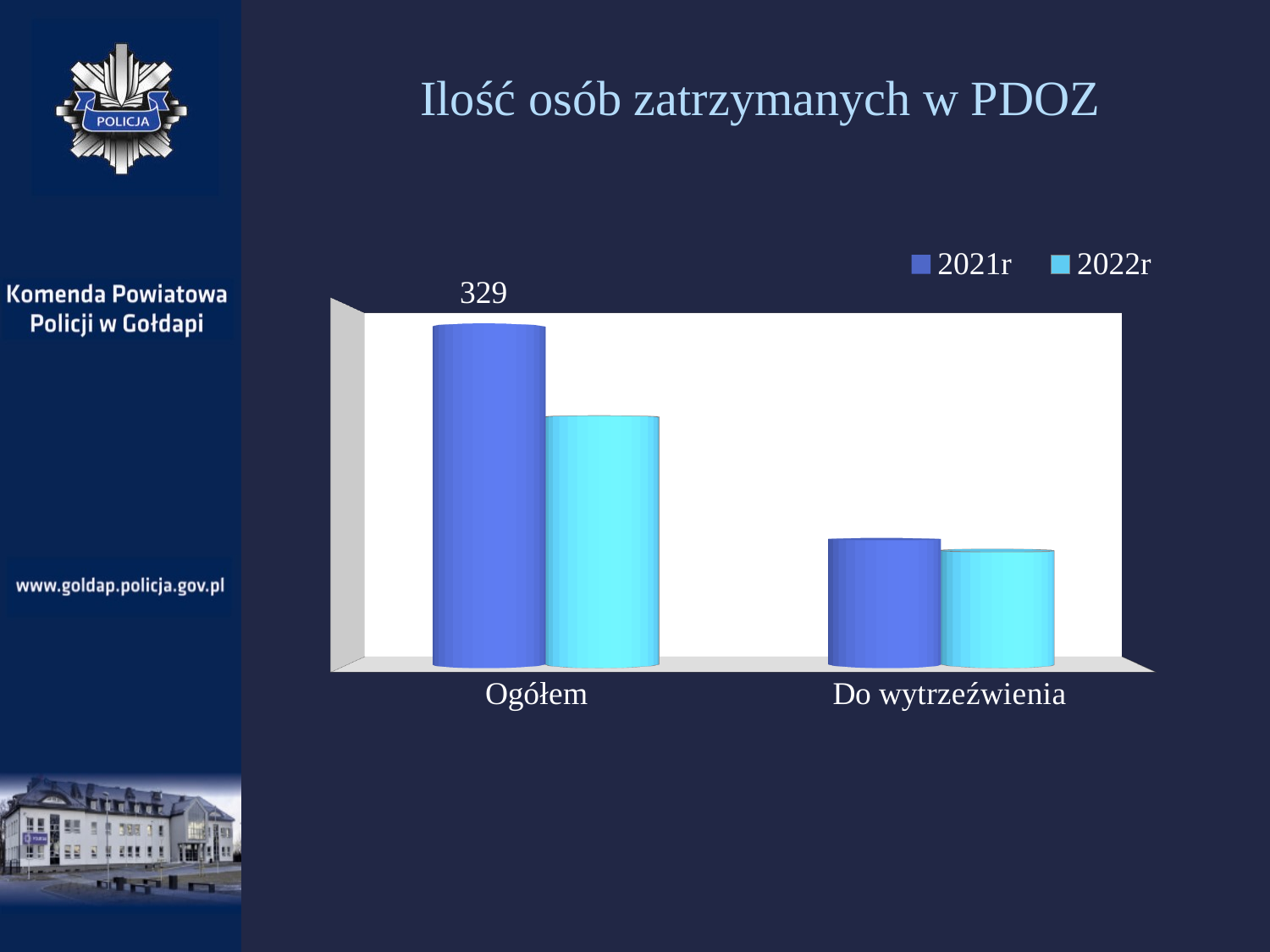
For the 2022r series, which category has the higher value, Ogółem or Do wytrzeźwienia? Ogółem How many categories are shown on the x axis? 2 What are the two series named in the legend? 2021r and 2022r Which category has the highest bar in the chart? Ogółem How many series does the legend list? 2 Which series has the larger value in the Ogółem category, 2021r or 2022r? 2021r What kind of chart is shown on the slide? bar chart Which series and category combination has the tallest bar? 2021r, Ogółem For the 2021r series, which category has the higher value, Ogółem or Do wytrzeźwienia? Ogółem Do the values for the 2021r series rise or fall from Ogółem to Do wytrzeźwienia? fall What is the title of the chart? Ilość osób zatrzymanych w PDOZ What is the value for 2021r in the Ogółem category? 329